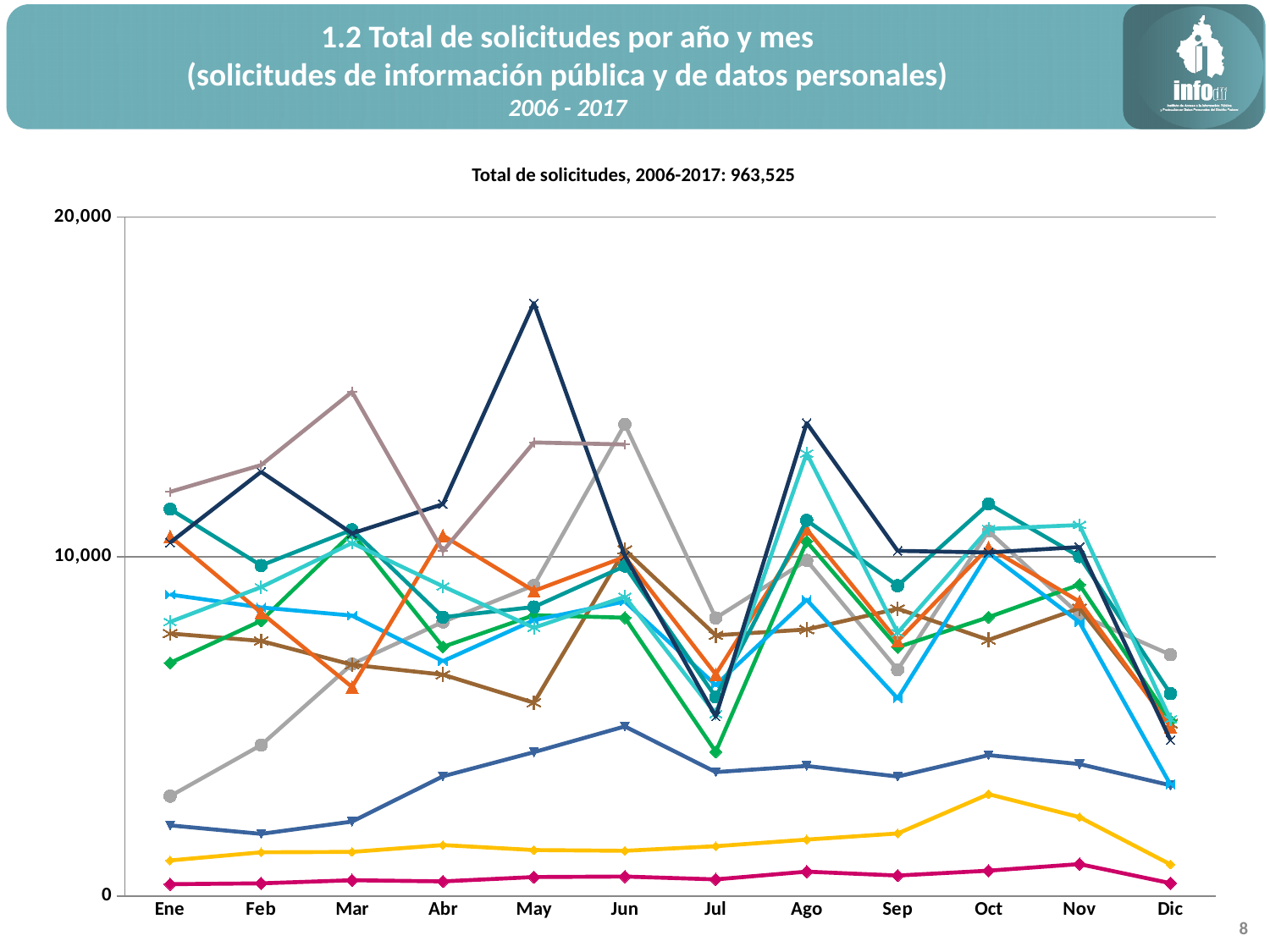
What kind of chart is shown on the slide? line chart Are all the values plotted for Dic greater or less than 10,000? less What is the first month label on the x axis? Ene How many months are shown along the x axis of the chart? 12 Which range of years does the chart cover according to the slide title? 2006 - 2017 In which month does the highest point on the chart occur? May What is the last month label on the x axis? Dic Is the highest point on the chart greater or less than 15,000? greater Are all the values plotted for Jul greater or less than 15,000? less What total number of solicitudes for 2006-2017 is printed above the chart? 963,525